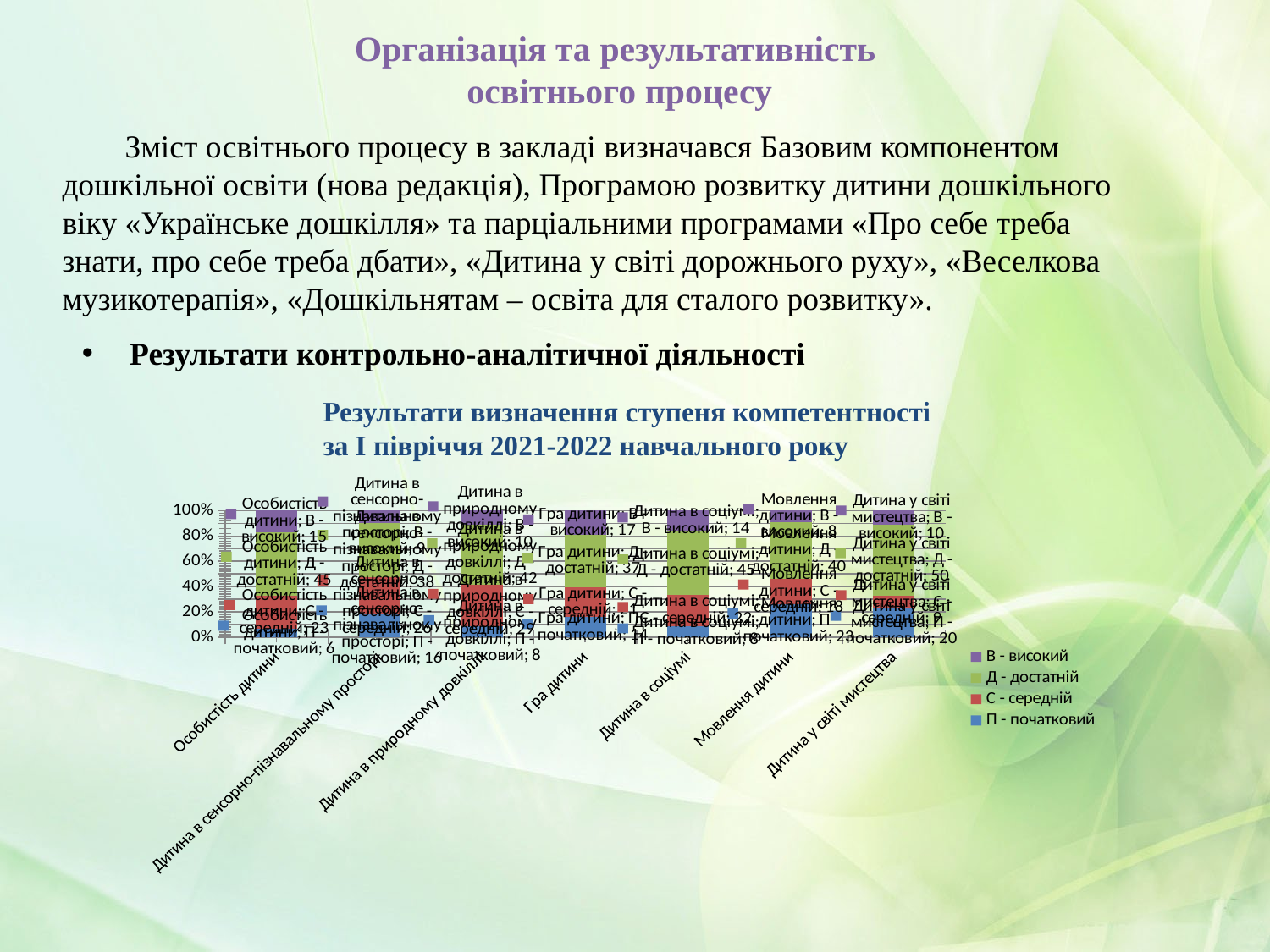
Which category has the highest value for the series 'Д - достатній'? Дитина у світі мистецтва What is the value of 'В - високий' for the category 'Гра дитини'? 17 What is the value of 'Д - достатній' for the category 'Мовлення дитини'? 40 How many categories are plotted along the x axis of the chart? 7 What is the difference between 'Д - достатній' for 'Дитина у світі мистецтва' (50) and 'Д - достатній' for 'Гра дитини' (37)? 13 What is the value of 'Д - достатній' for the category 'Дитина у світі мистецтва'? 50 Which is larger: 'В - високий' for 'Гра дитини' or 'В - високий' for 'Дитина в соціумі'? Гра дитини What kind of chart is shown on the slide? Stacked bar chart What is the title of the chart? Результати визначення ступеня компетентності за І півріччя 2021-2022 навчального року How many series does the chart legend list? 4 What is the value of 'В - високий' for the category 'Особистість дитини'? 15 What is the value of 'П - початковий' for the category 'Особистість дитини'? 6